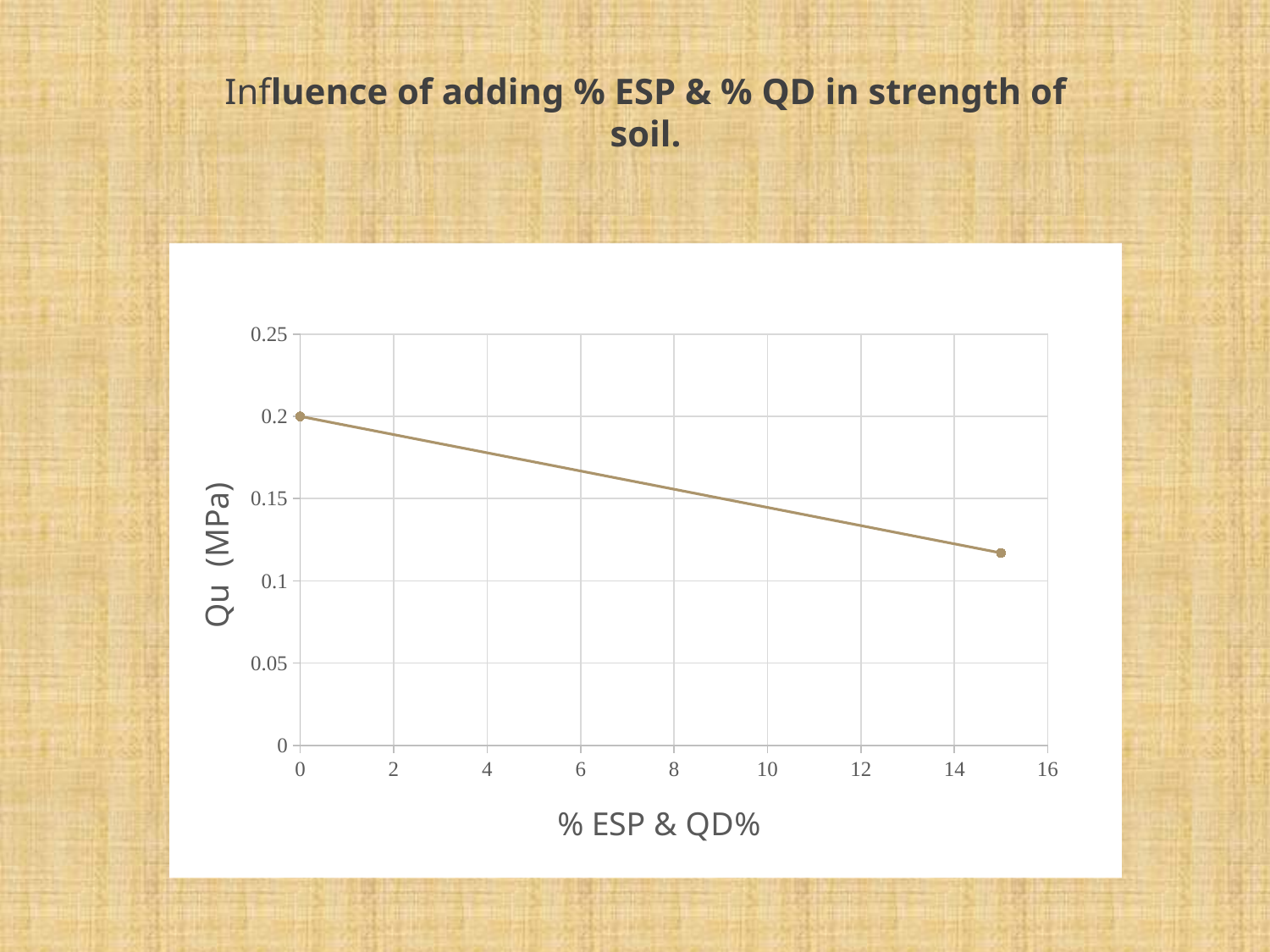
What is the label on the horizontal axis? % ESP & QD% Which data point has the higher Qu value, the left-hand point or the right-hand point? the left-hand point Is the Qu value of the right-hand data point greater or less than 0.15? less How many data points are plotted on the line? 2 At which x-axis value does the line reach its highest Qu? 0 What kind of chart is shown on the slide? line chart Is the Qu value of the right-hand data point greater or less than 0.1? greater What is the Qu (MPa) value at 0 % ESP & QD%? 0.2 Does Qu rise or fall as % ESP & QD% increases along the x axis? fall Is the Qu value at 0 % ESP & QD% greater or less than 0.15? greater What is the label on the vertical axis? Qu (MPa)